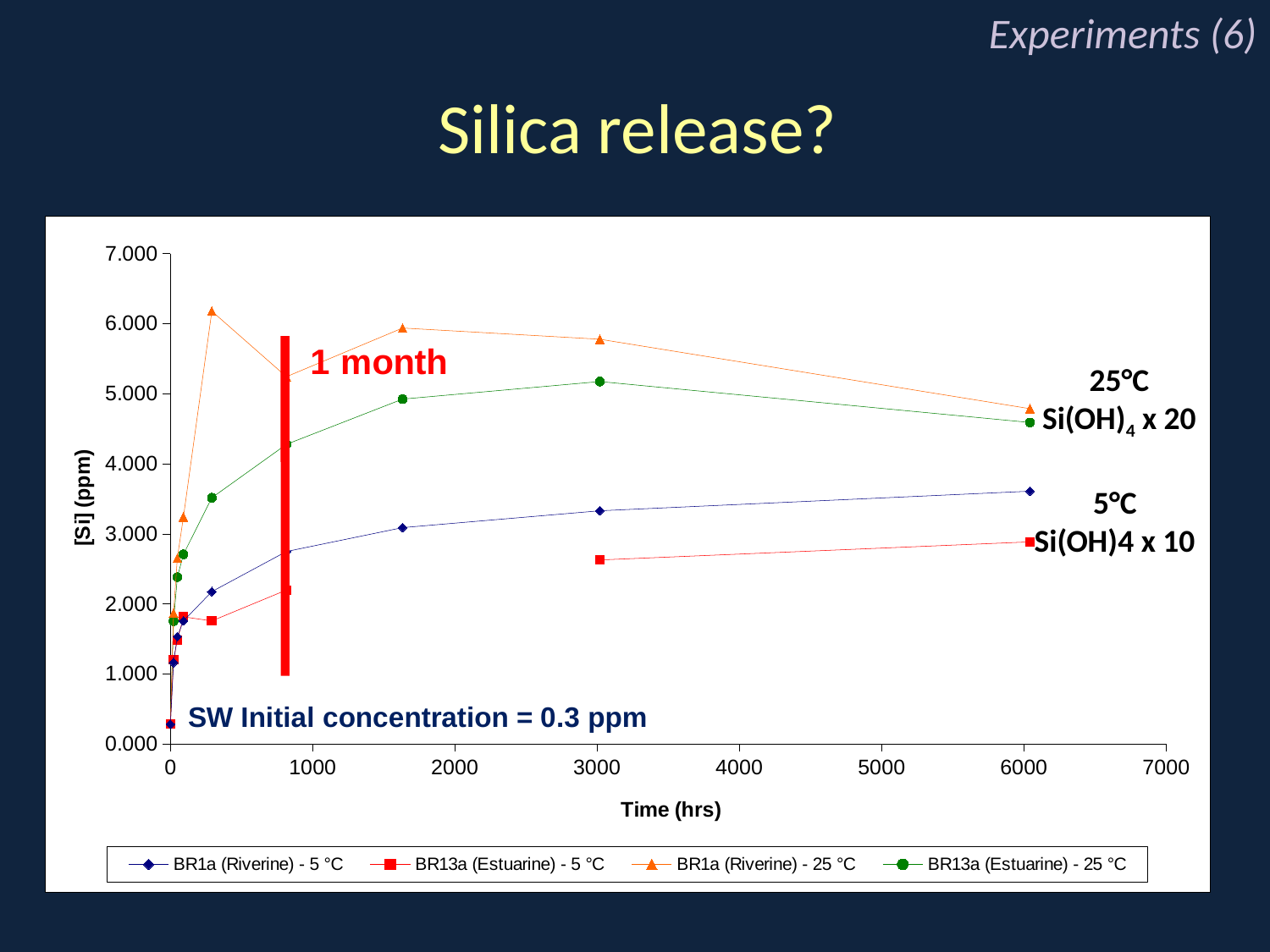
Is the value for BR1a (Riverine) - 5 °C at about 6000 hrs greater or less than 3.000? greater Which series reaches the highest [Si] value on the chart? BR1a (Riverine) - 25 °C What kind of chart is shown on the slide? Line chart At about 6000 hrs, which is larger: BR1a (Riverine) - 5 °C or BR13a (Estuarine) - 5 °C? BR1a (Riverine) - 5 °C How many series does the legend list? 4 Does the BR1a (Riverine) - 5 °C series rise or fall as time increases? Rise Which series has the lowest [Si] value at the right-hand end of the chart (around 6000 hrs)? BR13a (Estuarine) - 5 °C What is the label of the x axis? Time (hrs) Is the value for BR13a (Estuarine) - 5 °C at about 3000 hrs greater or less than 3.000? less Is the value for BR1a (Riverine) - 25 °C at about 6000 hrs greater or less than 5.000? less What is the label of the y axis? [Si] (ppm)